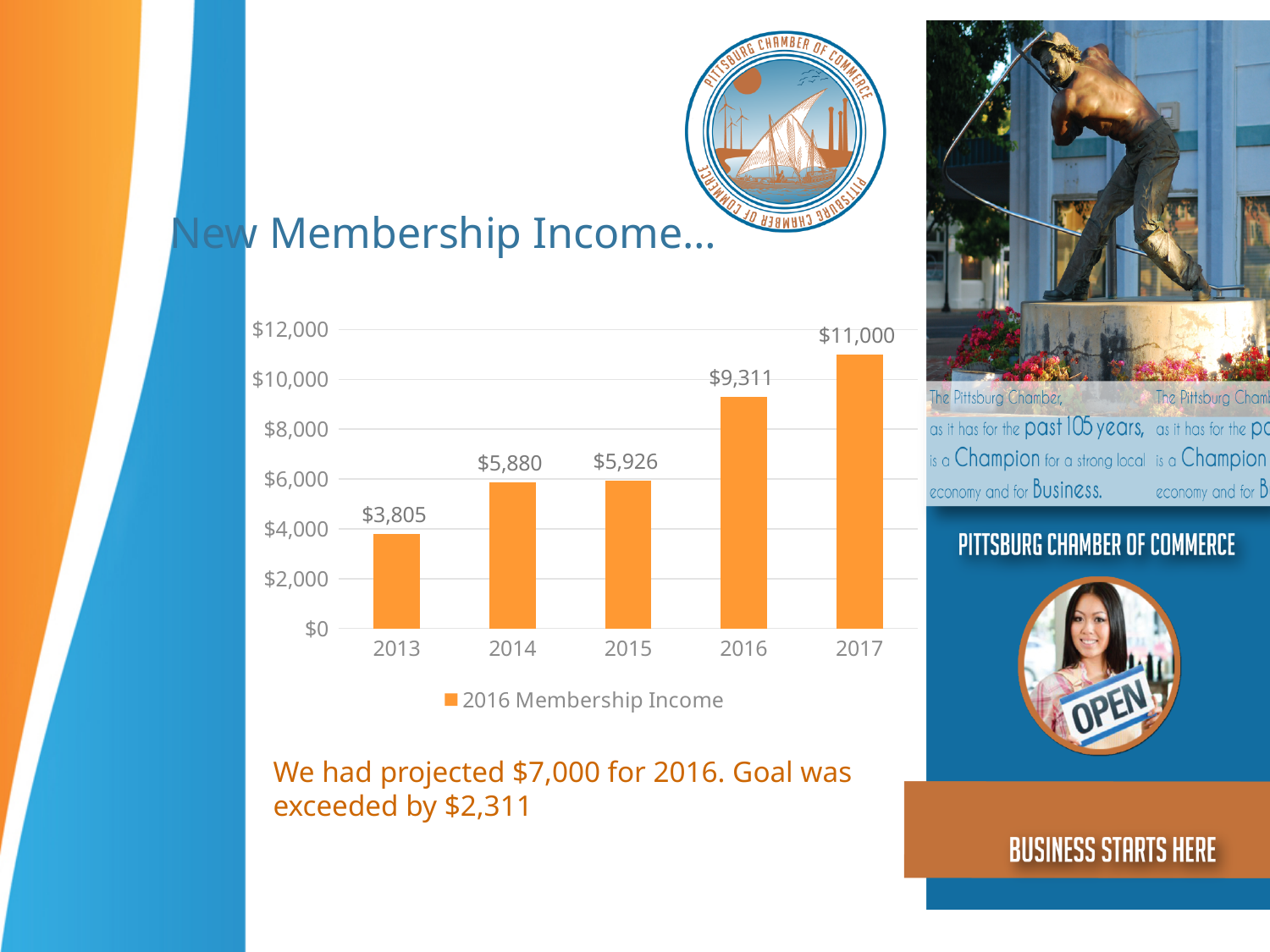
What is the difference between the values for 2017 and 2016? $1,689 Is the value for 2016 greater or less than $8,000? greater What is the difference between the values for 2014 and 2013? $2,075 Which year has the lowest value? 2013 Which year has the highest value? 2017 How many years are shown on the x axis? 5 What is the value for 2013? $3,805 What is the value for 2016? $9,311 What kind of chart is shown on the slide? bar chart Which is larger, the value for 2016 or the value for 2015? 2016 Do the values rise or fall from 2013 to 2017? rise What is the value for 2017? $11,000